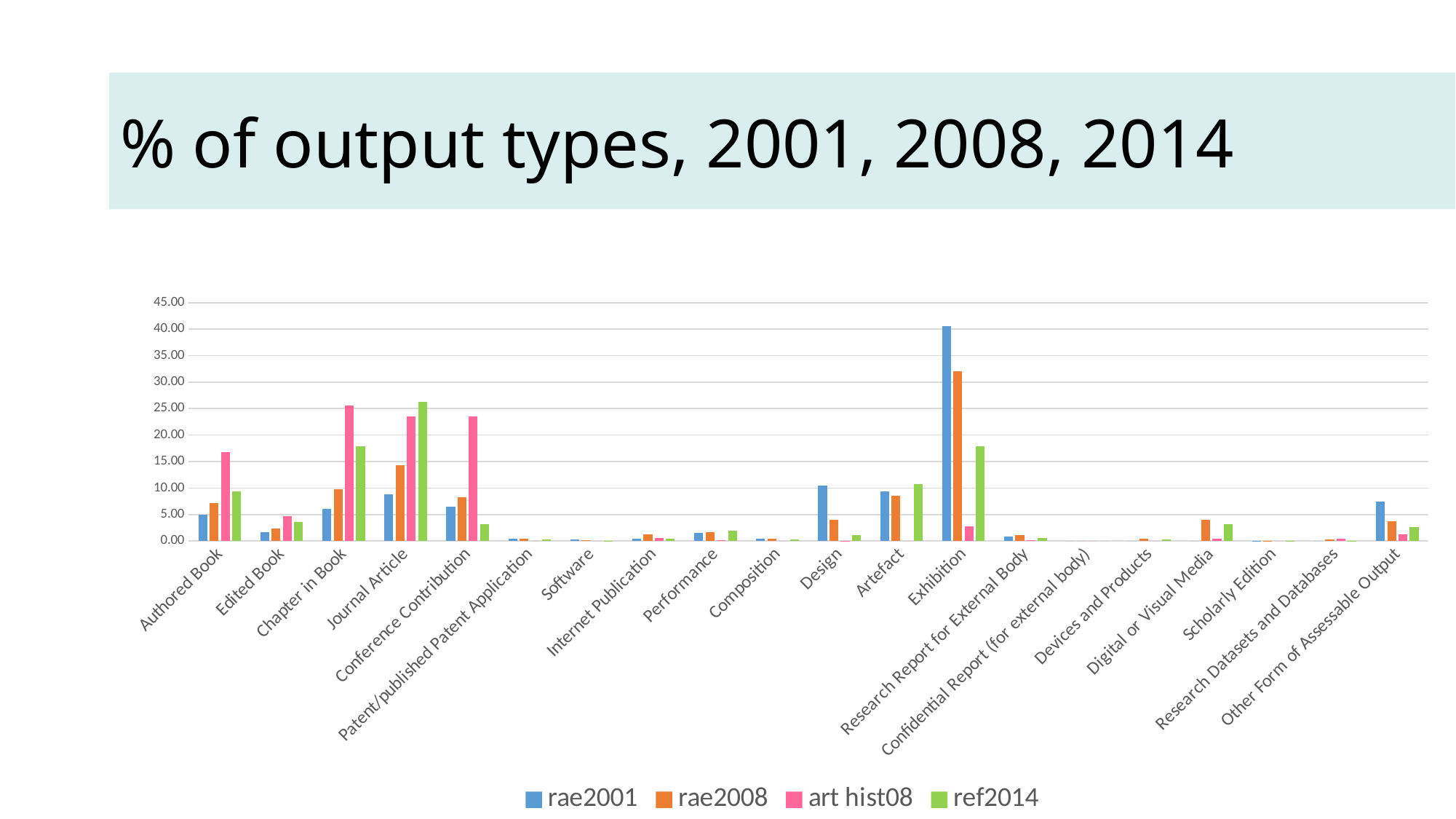
Is the art hist08 value for Authored Book greater or less than 15.00? greater Which category has the highest ref2014 value? Journal Article Which category has the highest art hist08 value? Chapter in Book Is the rae2008 value for Exhibition greater or less than 30.00? greater For Exhibition, which is larger: the rae2001 value or the rae2008 value? rae2001 How many output type categories are shown on the x axis? 20 How many series does the legend list? 4 Is the rae2001 value for Exhibition greater or less than 35.00? greater What kind of chart is shown on the slide? bar chart Which category has the highest rae2001 value? Exhibition For Authored Book, which is larger: the art hist08 value or the ref2014 value? art hist08